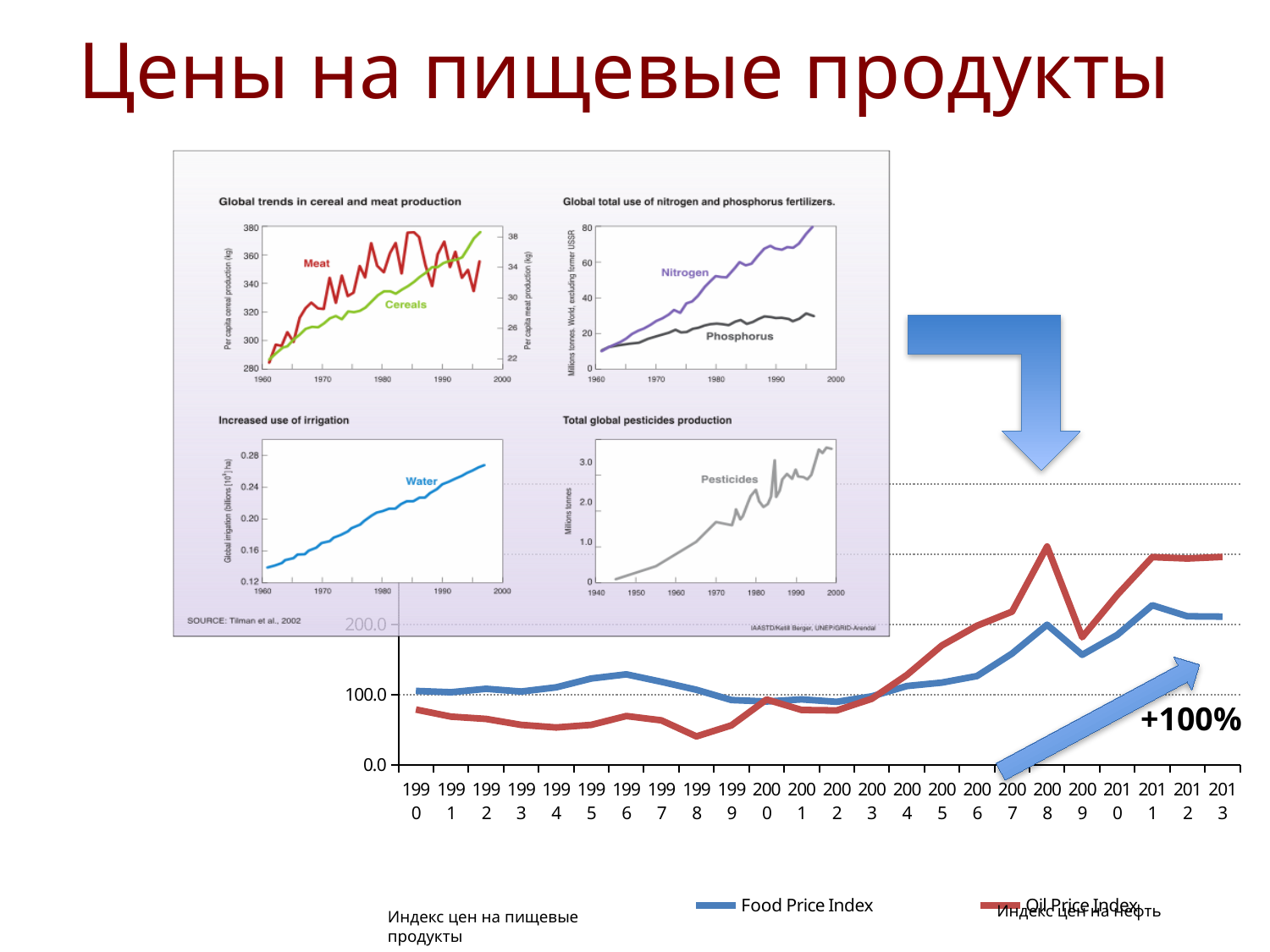
How many series does the legend of the Food Price Index / Oil Price Index chart list? 2 In the Food Price Index / Oil Price Index chart, which series has the higher value in 2013, Food Price Index or Oil Price Index? Oil Price Index In the Food Price Index / Oil Price Index chart, which year has the lowest Oil Price Index value? 1998 In the small chart titled 'Global total use of nitrogen and phosphorus fertilizers', which line is higher in 1990, Nitrogen or Phosphorus? Nitrogen What are the two series named in the legend of the large line chart at the bottom of the slide? Food Price Index and Oil Price Index In the Food Price Index / Oil Price Index chart, does the Food Price Index overall rise or fall between 2000 and 2011? rise In the Food Price Index / Oil Price Index chart, which year has the highest Oil Price Index value? 2008 In the Food Price Index / Oil Price Index chart, is the Oil Price Index value for 2008 greater or less than 200? greater What kind of chart is the large chart at the bottom of the slide showing the Food Price Index and Oil Price Index? line chart How many years are shown on the x axis of the Food Price Index / Oil Price Index chart? 24 In the Food Price Index / Oil Price Index chart, which series has the higher value in 1990, Food Price Index or Oil Price Index? Food Price Index In the Food Price Index / Oil Price Index chart, is the Oil Price Index value for 1998 greater or less than 100? less